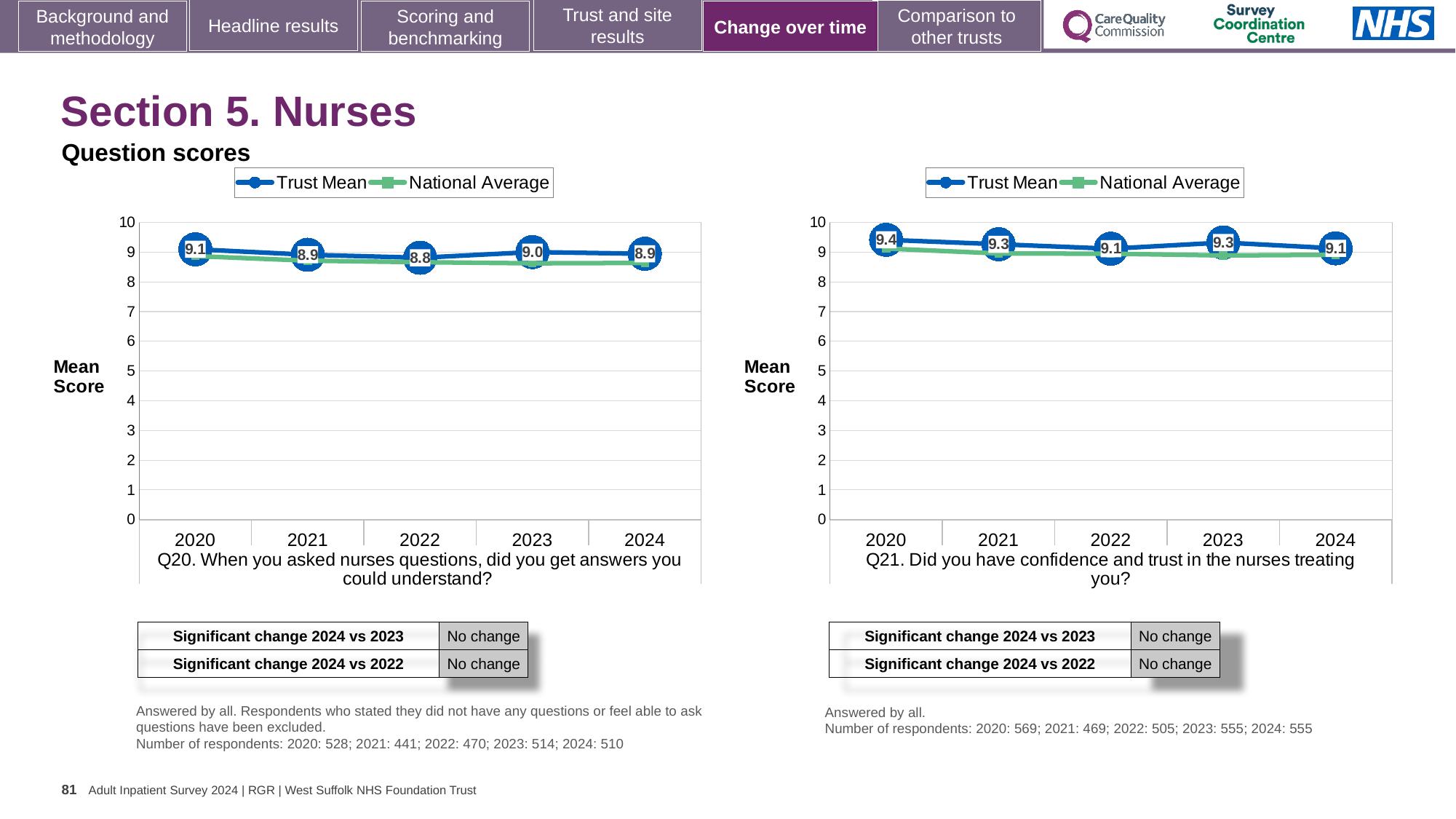
In the Q20 chart on the left, is the National Average value for 2024 greater or less than 8? greater What are the two series named in the legend of the Q21 chart on the right? Trust Mean and National Average How many years are plotted on the x axis of the Q21 chart on the right? 5 In the Q21 chart on the right, what is the Trust Mean score for 2022? 9.1 In the Q20 chart on the left, what is the Trust Mean score for 2020? 9.1 In the Q21 chart on the right, which year has the highest Trust Mean score? 2020 In the Q20 chart on the left, what is the difference between the Trust Mean scores for 2020 and 2022? 0.3 In the Q20 chart on the left, does the Trust Mean score rise or fall from 2020 to 2022? Fall What kind of chart is the Q21 chart on the right? Line chart In the Q20 chart on the left, which year has the lowest Trust Mean score? 2022 How many series does the legend of the Q20 chart on the left list? 2 In the Q21 chart on the right, which year has the larger Trust Mean score, 2020 or 2024? 2020